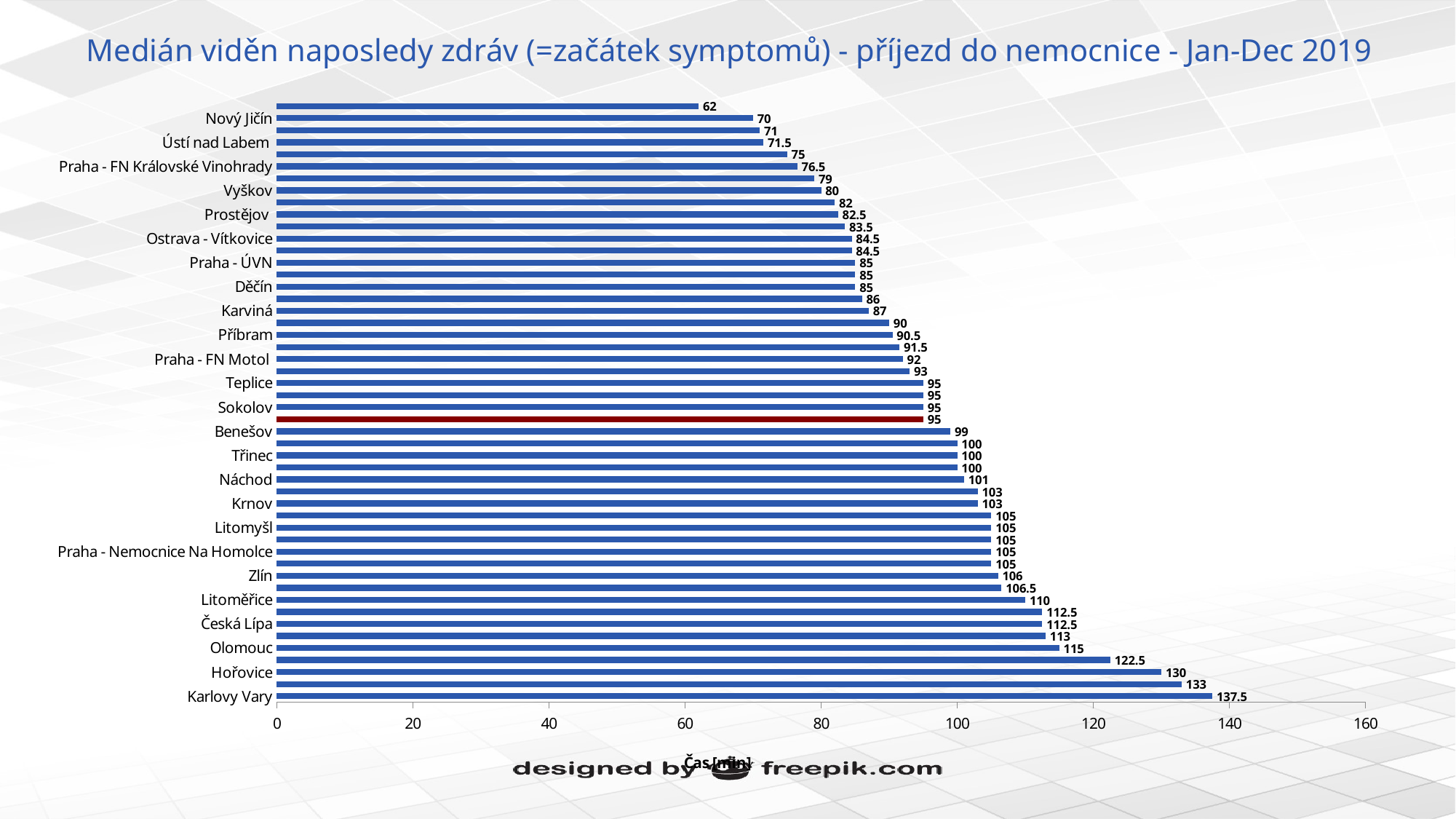
What is the difference between the values for Karlovy Vary and Nový Jičín? 67.5 What is the value for Karlovy Vary? 137.5 What is the title of the x axis? Čas [min] What is the value for Nový Jičín? 70 What is the highest value shown on the chart? 137.5 What is the value for Hořovice? 130 What is the value for Vyškov? 80 Which has a larger value, Olomouc or Vyškov? Olomouc What kind of chart is shown? bar chart What value is labelled on the single red bar? 95 Is the value for Sokolov greater or less than 80? greater Which labelled hospital has the highest value? Karlovy Vary